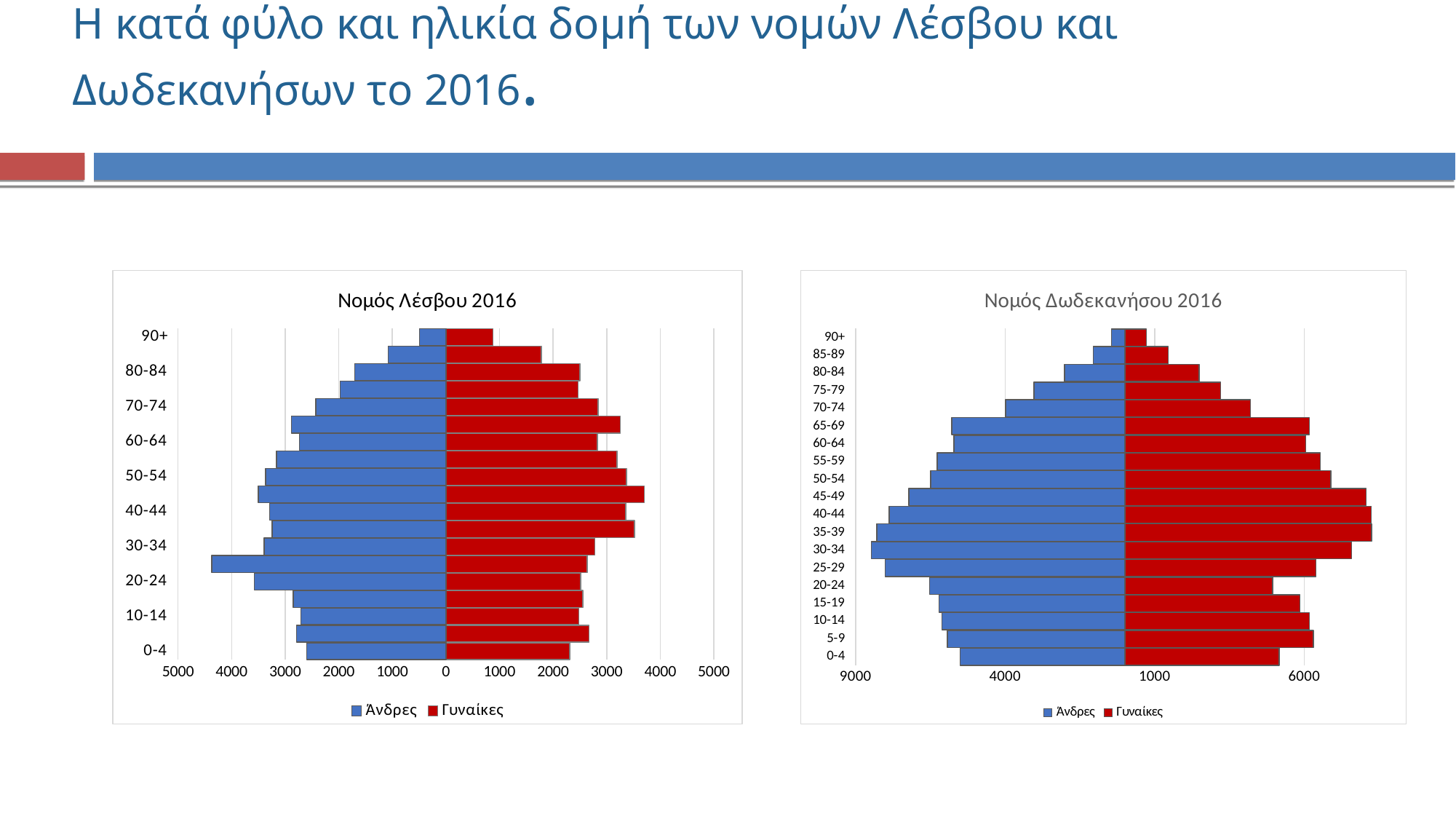
In the 'Νομός Λέσβου 2016' chart, is the value for Άνδρες aged 90+ greater or less than 1000? less In the 'Νομός Λέσβου 2016' chart, which series is shown in red? Γυναίκες In the 'Νομός Δωδεκανήσου 2016' chart, do the Άνδρες values rise or fall going from the 30-34 group up to the 90+ group? fall What kind of chart is the 'Νομός Λέσβου 2016' chart? bar chart In the 'Νομός Δωδεκανήσου 2016' chart, is the value for Άνδρες aged 30-34 greater or less than 4000? greater In the 'Νομός Δωδεκανήσου 2016' chart, which is larger for Γυναίκες: the 65-69 group or the 80-84 group? 65-69 How many age groups are plotted in the 'Νομός Δωδεκανήσου 2016' chart? 19 How many series does the legend of the 'Νομός Δωδεκανήσου 2016' chart list? 2 In the 'Νομός Λέσβου 2016' chart, is the value for Γυναίκες aged 40-44 greater or less than 3000? greater In the 'Νομός Δωδεκανήσου 2016' chart, which age group has the largest value for Άνδρες? 30-34